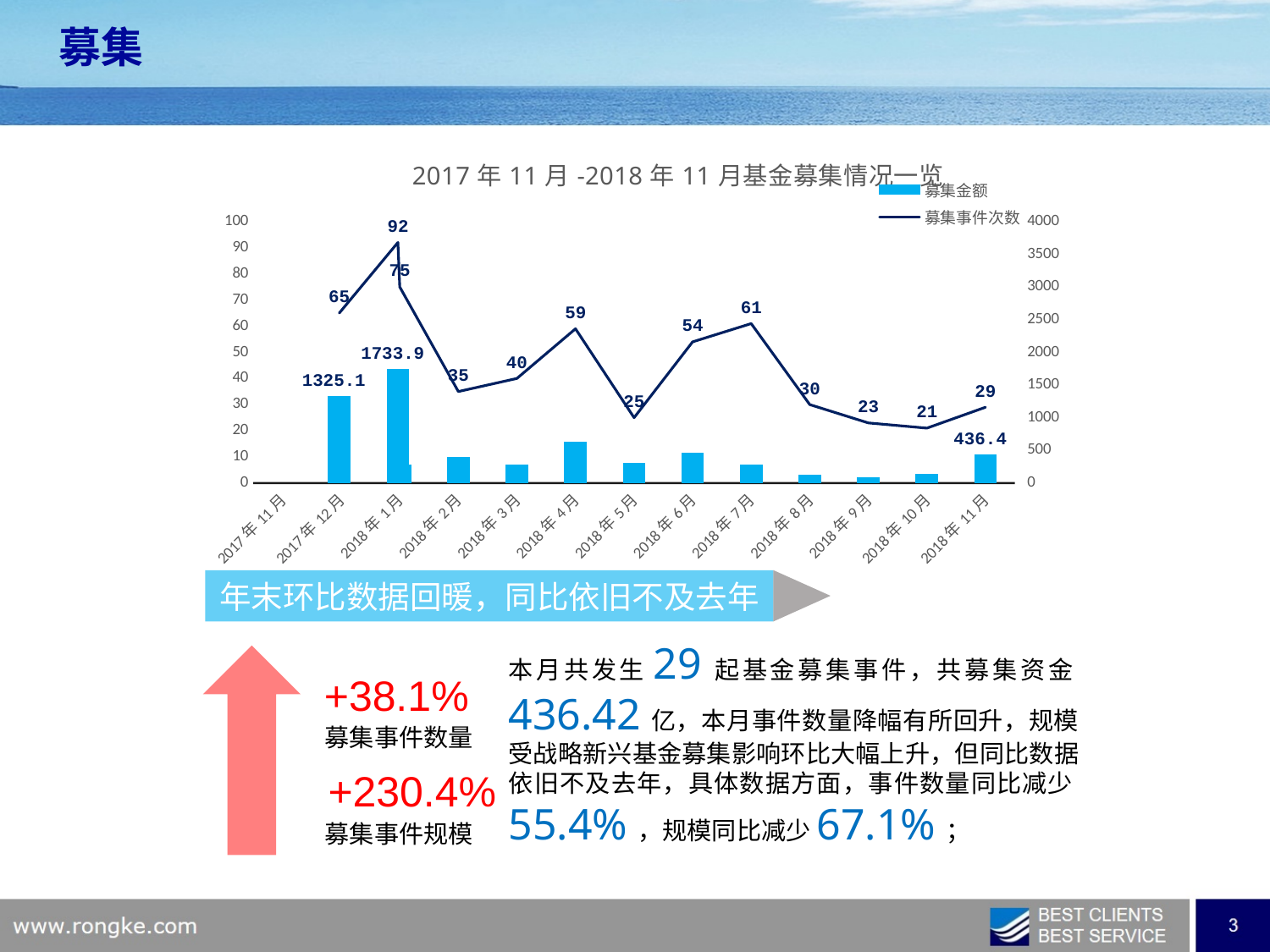
Which month has the lowest 募集事件次数? 2018年10月 What type of chart is shown on the slide? Combined bar and line chart What is the 募集事件次数 value for 2018年10月? 21 How many series does the legend list? 2 Is the 募集金额 value for 2018年2月 greater or less than 1000? less What is the 募集金额 value for 2018年11月? 436.4 Which is larger, the 募集事件次数 for 2018年4月 or for 2018年5月? 2018年4月 How many months are shown on the x axis? 13